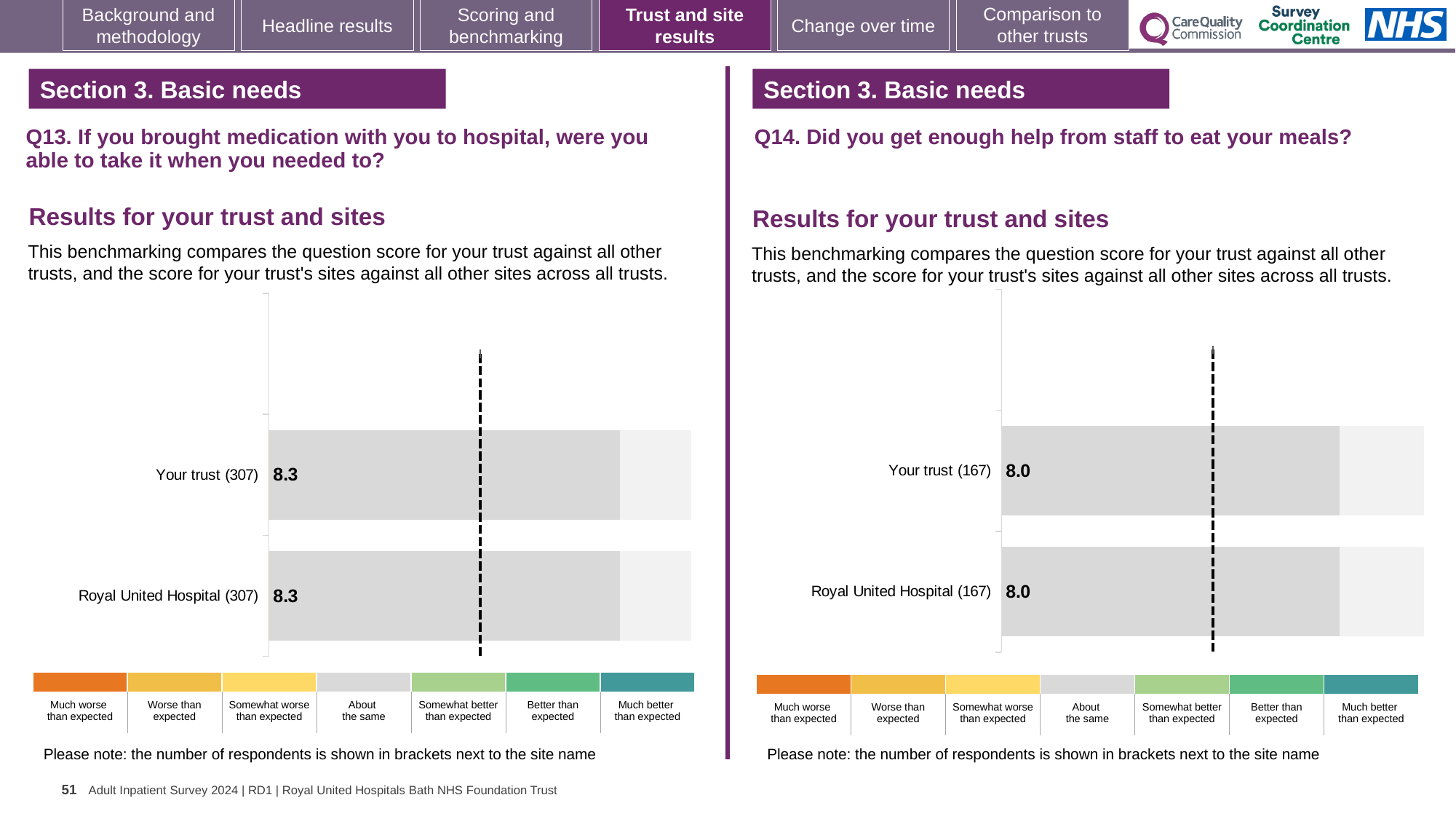
In the Q14 chart on the right, how many respondents are shown in brackets for Royal United Hospital? 167 In the Q14 chart on the right, how many bars are plotted? 2 In the Q13 chart on the left, how many respondents are shown in brackets for Your trust? 307 In the Q14 chart on the right, how many benchmark categories does the colour key below the chart list? 7 In the Q14 chart on the right, what is the score for Royal United Hospital? 8.0 In the Q13 chart on the left, which benchmark category does the colour key show in dark orange? Much worse than expected In the Q13 chart on the left, how many bars are plotted? 2 What kind of chart is the Q13 chart on the left? Bar chart In the Q13 chart on the left, what is the difference between the score for Your trust and the score for Royal United Hospital? 0 In the Q13 chart on the left, what is the score for Royal United Hospital? 8.3 In the Q13 chart on the left, what is the score for Your trust? 8.3 In the Q14 chart on the right, what is the score for Your trust? 8.0